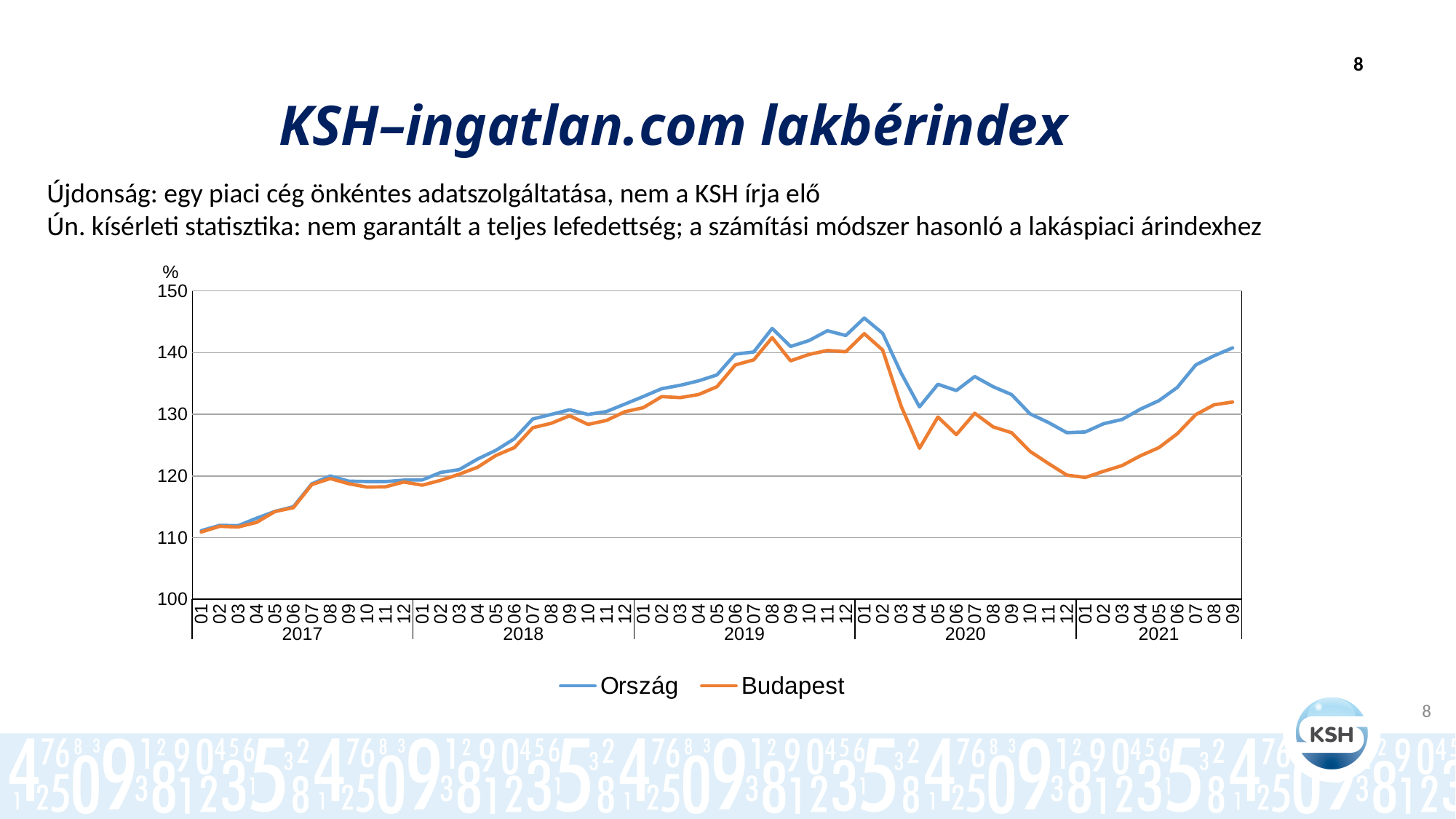
In which month does the Ország series reach its highest value? 2020-01 Do the values of the Ország series rise or fall from 2017-01 to 2019-12? rise In 2020-04, which series has the larger value, Ország or Budapest? Ország Which colour is used for the Budapest series? orange What kind of chart is shown on the slide? line chart Is the value for Ország in 2020-01 greater or less than 140? greater Is the value for Ország in 2019-08 greater or less than 140? greater What are the two series named in the legend? Ország and Budapest Is the value for Budapest in 2020-04 greater or less than 130? less In which month is the Budapest series at its lowest value? 2017-01 How many series does the legend list? 2